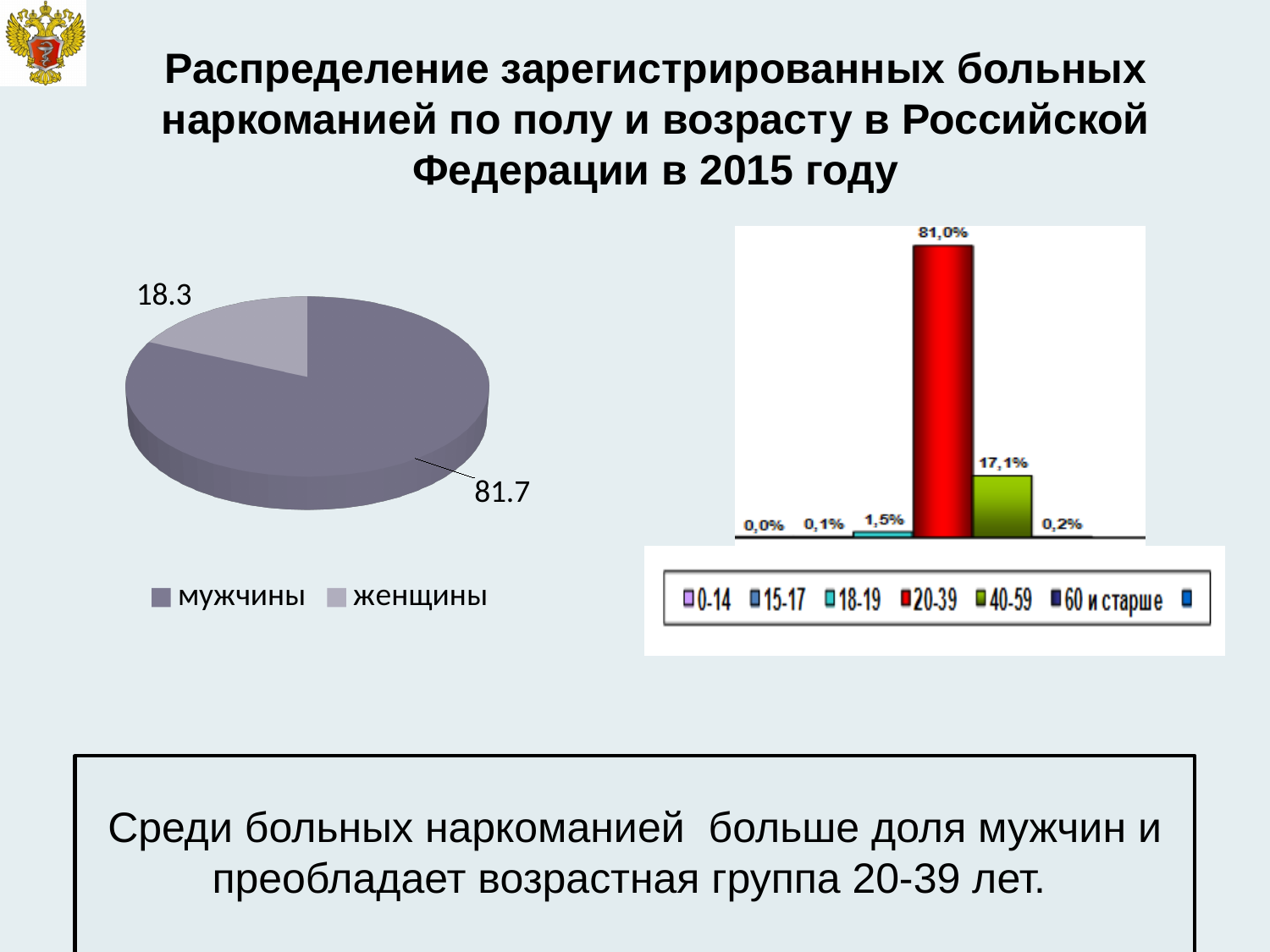
On the bar chart on the right, which age group has the highest value? 20-39 On the bar chart on the right, what is the value for the 20-39 age group? 81,0% On the bar chart on the right, what is the difference between the 20-39 and 40-59 values? 63,9% On the pie chart on the left, what is the difference between the мужчины and женщины values? 63.4 On the pie chart on the left, which slice is larger, мужчины or женщины? мужчины On the pie chart on the left, what is the value for мужчины? 81.7 On the pie chart on the left, what is the value for женщины? 18.3 What kind of chart is the chart on the left? pie chart On the bar chart on the right, what is the value for the 18-19 age group? 1,5% On the pie chart on the left, how many entries does the legend list? 2 What kind of chart is the chart on the right? bar chart On the bar chart on the right, what is the value for the 40-59 age group? 17,1%